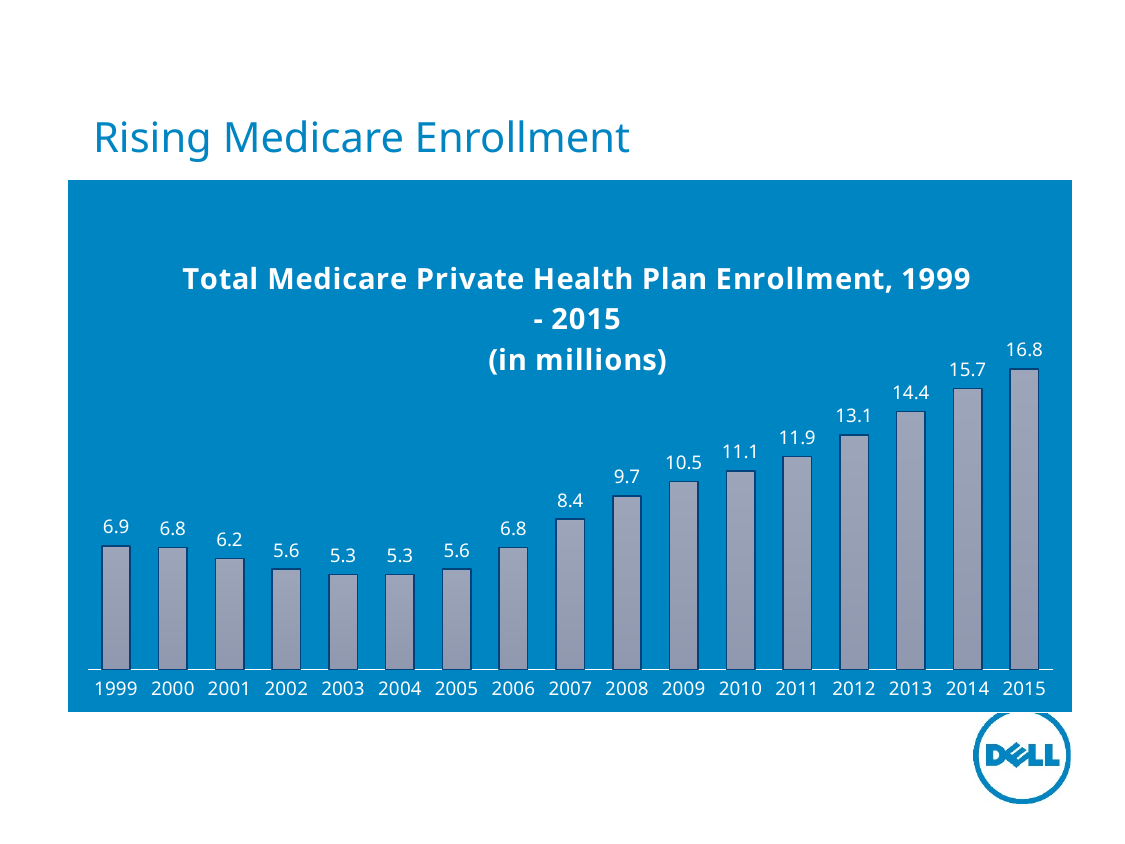
What is the enrollment value shown for 2009? 10.5 What kind of chart is shown on the slide? Bar chart What is the difference between the enrollment values for 2008 and 2007? 1.3 What is the difference between the enrollment values for 2015 and 1999? 9.9 What is the lowest enrollment value shown on the chart? 5.3 Which year has the highest enrollment value? 2015 Which year has a larger enrollment value, 2001 or 2006? 2006 How many years are shown on the x axis of the chart? 17 What is the enrollment value shown for 2012? 13.1 In what units are the values on the chart expressed, according to the chart title? Millions What is the enrollment value shown for 1999? 6.9 Do the enrollment values generally rise or fall from 2004 to 2015? Rise